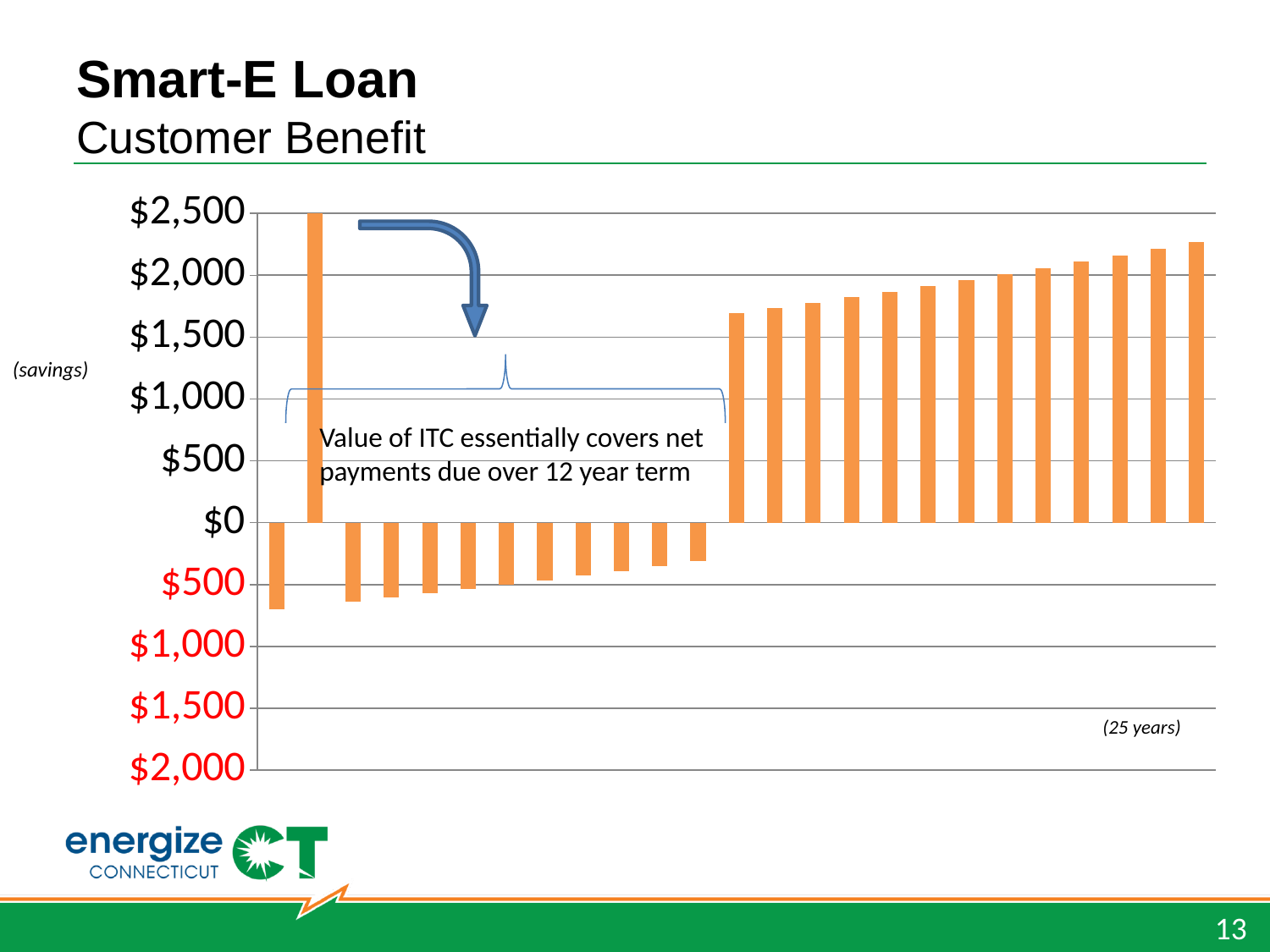
Is the value for the rightmost bar greater or less than $2,000? greater What kind of chart is shown on the slide? bar chart What does the annotation inside the chart say? Value of ITC essentially covers net payments due over 12 year term How many bars are plotted in the chart? 25 How many bars in the chart extend below $0? 11 What is the highest tick value shown on the vertical axis? $2,500 Is the value for the first positive bar to the right of the annotation box greater or less than $1,500? greater Do the positive bars on the right half of the chart rise or fall from left to right? rise What label appears in parentheses at the bottom right of the chart? (25 years) Is the value for the leftmost bar greater or less than $0? less Which bar is the tallest in the chart? the second bar from the left